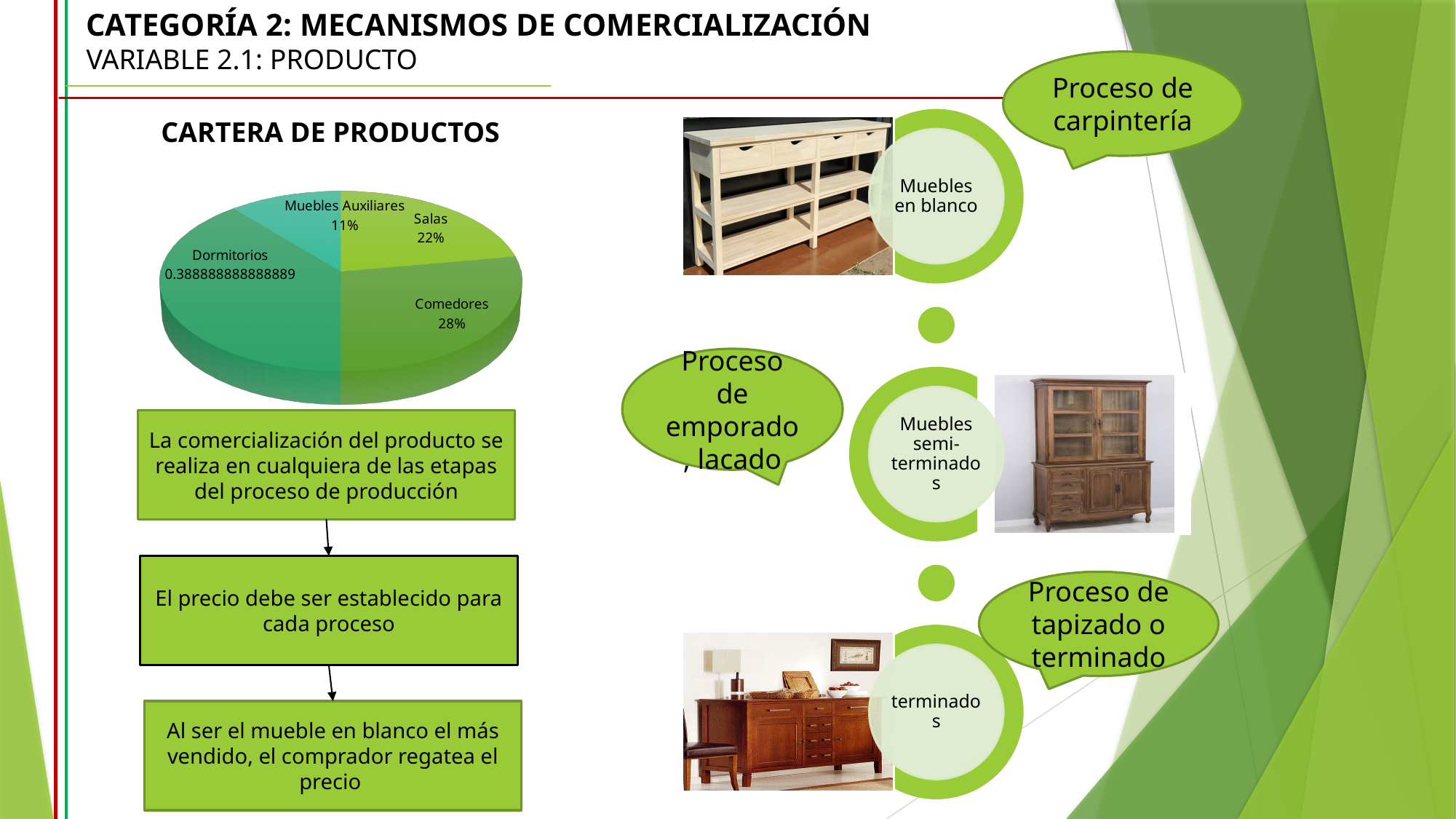
How many categories are shown in the pie chart? 4 What value is shown for Salas in the pie chart? 22% How many percentage points larger is Salas than Muebles Auxiliares in the pie chart? 11 How many percentage points larger is Comedores than Salas in the pie chart? 6 Which is larger in the pie chart, Comedores or Salas? Comedores What percentage of the pie chart does Comedores represent? 28% What type of chart is used to show the product portfolio? Pie chart Which category has the largest slice in the pie chart? Dormitorios Which category has the smallest slice in the pie chart? Muebles Auxiliares What value is printed for Dormitorios in the pie chart? 0.388888888888889 What is the title of the chart on the slide? CARTERA DE PRODUCTOS What value is shown for Muebles Auxiliares in the pie chart? 11%